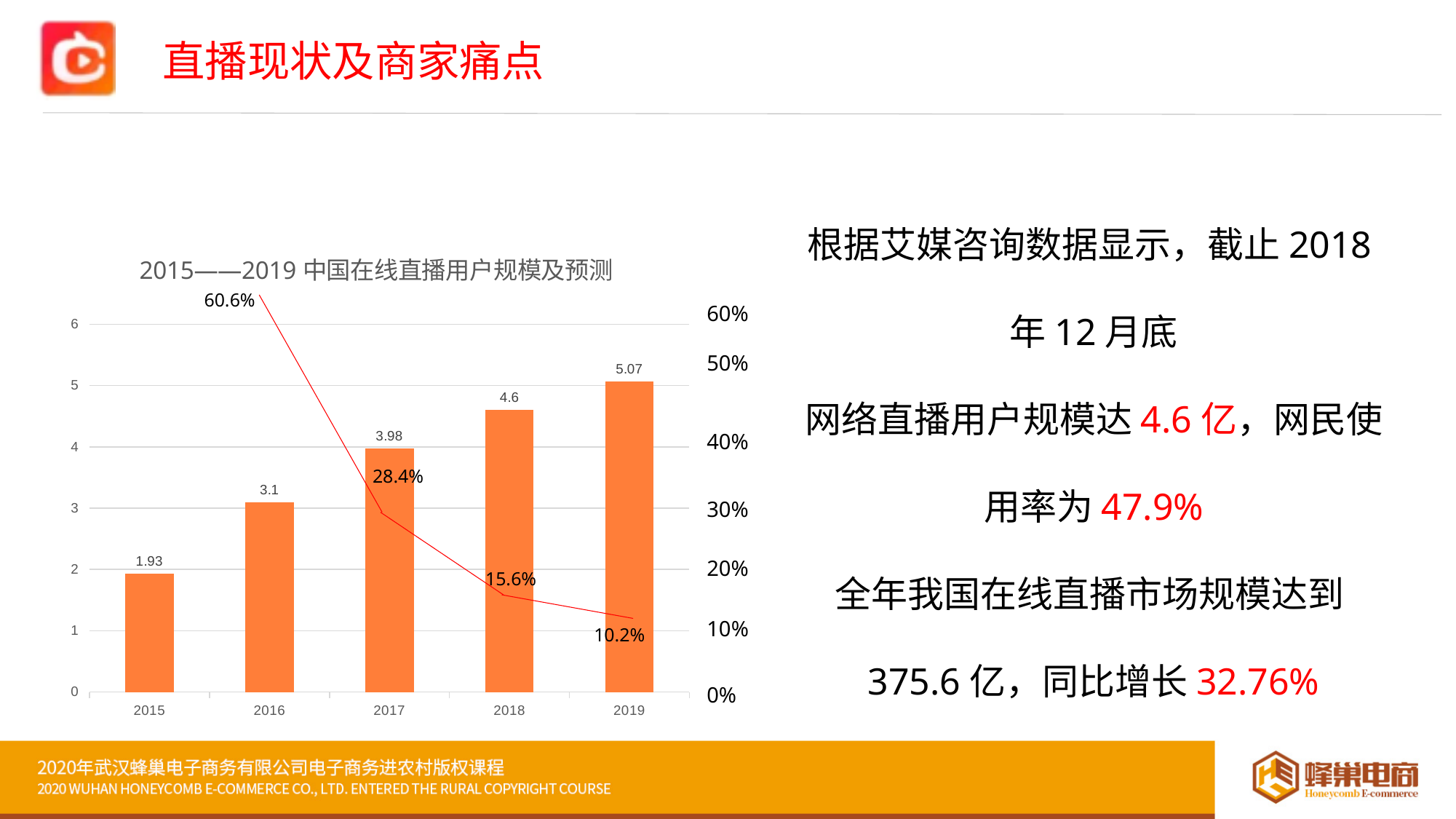
What percentage does the red line show for 2017? 28.4% Which year has the lowest bar? 2015 What is the bar value for 2015? 1.93 What is the bar value for 2019? 5.07 Which year has the highest bar? 2019 Do the bar values rise or fall from 2015 to 2019? rise What is the title of the chart? 2015——2019 中国在线直播用户规模及预测 Which is larger, the bar value for 2016 or for 2017? 2017 How many years are shown on the x axis? 5 What is the bar value for 2018? 4.6 What is the difference between the bar values for 2019 and 2018? 0.47 What percentage does the red line show for 2019? 10.2%